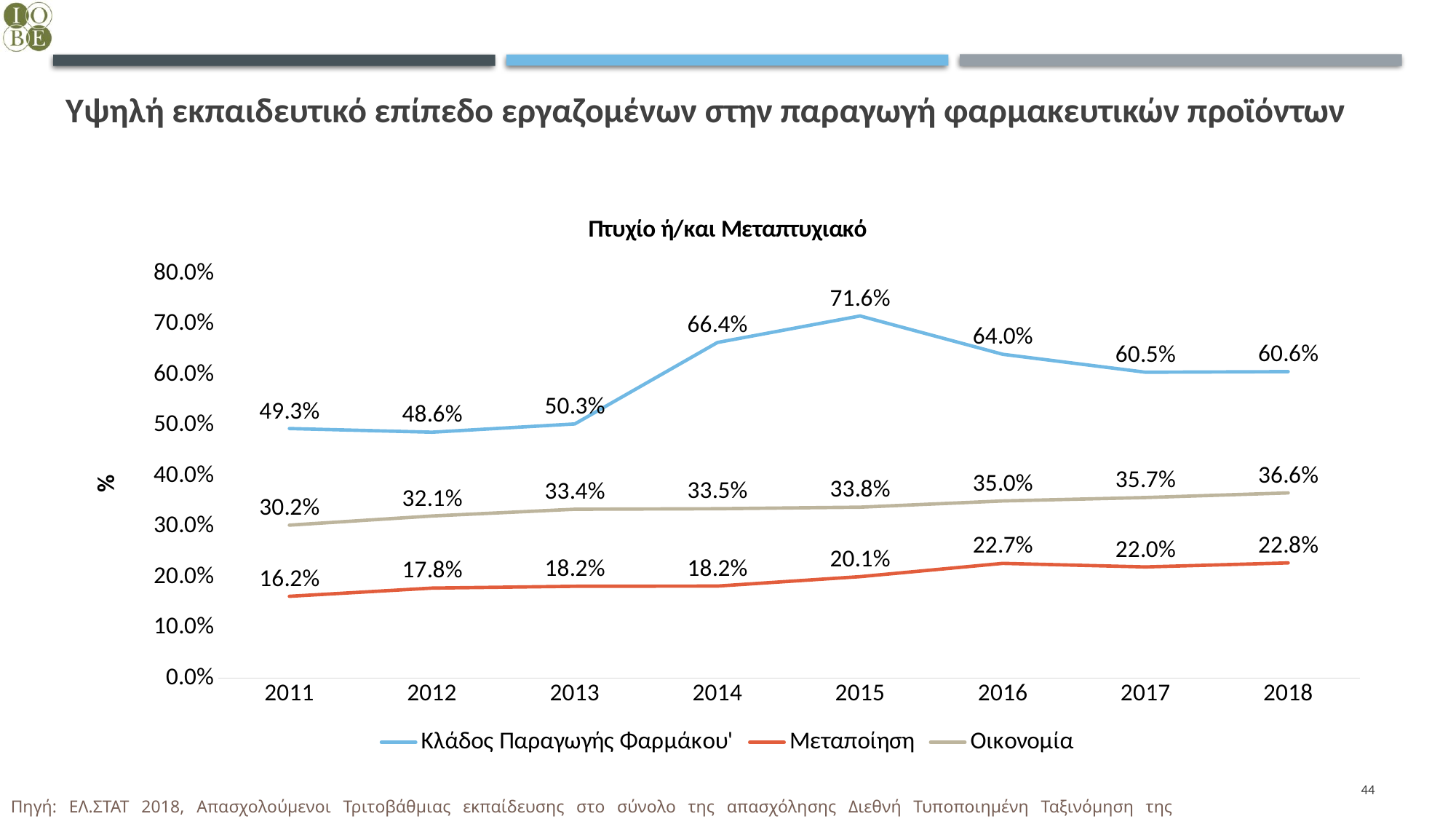
Which is larger in 2016: Οικονομία or Μεταποίηση? Οικονομία What is the value for Κλάδος Παραγωγής Φαρμάκου in 2015? 71.6% In which year does Κλάδος Παραγωγής Φαρμάκου reach its highest value? 2015 Does the value for Οικονομία rise or fall from 2011 to 2018? rise How many years are shown on the x axis? 8 What is the title of the chart? Πτυχίο ή/και Μεταπτυχιακό In which year is the value for Μεταποίηση lowest? 2011 What is the value for Οικονομία in 2018? 36.6% How many series does the legend list? 3 What is the value for Μεταποίηση in 2011? 16.2% What type of chart is shown on the slide? line chart What is the difference between Κλάδος Παραγωγής Φαρμάκου and Οικονομία in 2018? 24.0%